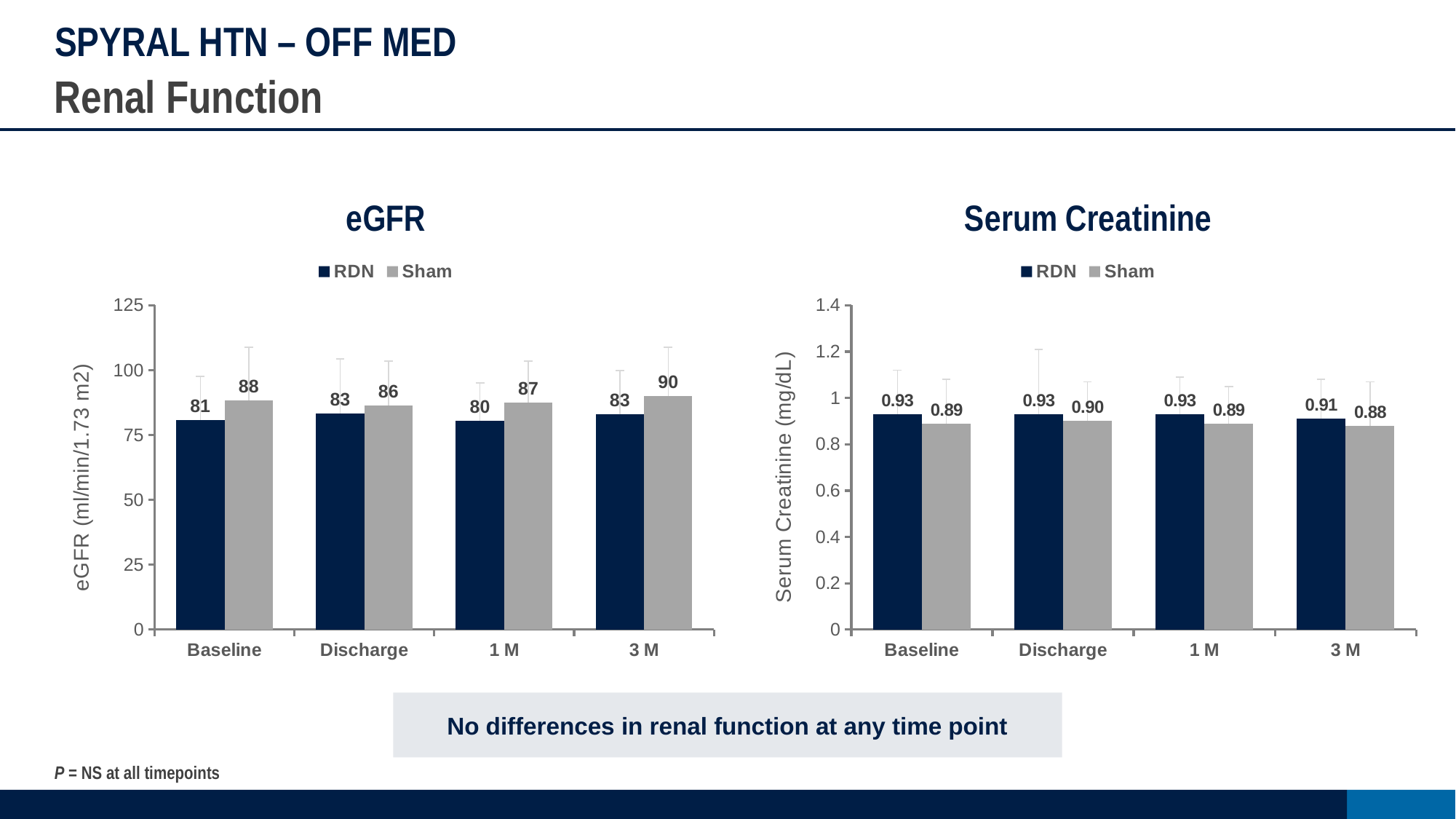
In the Serum Creatinine chart, what is the RDN value at 3 M? 0.91 How many series does the legend of the eGFR chart list? 2 In the Serum Creatinine chart, what is the difference between the RDN and Sham values at 1 M? 0.04 In the eGFR chart, what is the RDN value at Baseline? 81 In the eGFR chart, which is larger at 1 M, the RDN value or the Sham value? Sham In the eGFR chart, what is the Sham value at 3 M? 90 In the eGFR chart, at which time point is the Sham value highest? 3 M In the eGFR chart, what is the difference between the Sham and RDN values at Baseline? 7 How many time points are shown on the x axis of the Serum Creatinine chart? 4 In the Serum Creatinine chart, what is the Sham value at Discharge? 0.90 What type of chart is the Serum Creatinine chart? Bar chart In the eGFR chart, at which time point is the RDN value lowest? 1 M